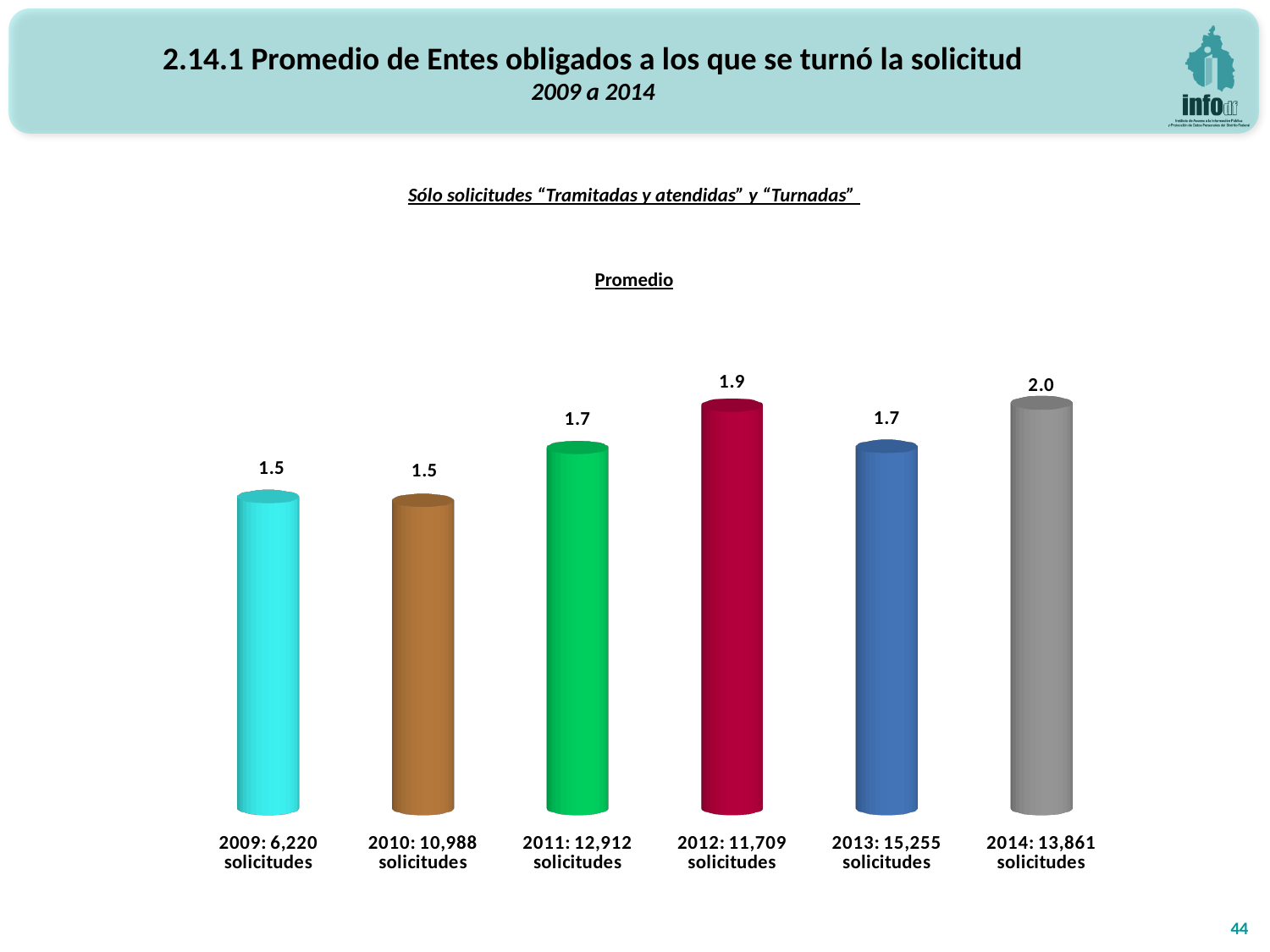
How many solicitudes are indicated in the category label for 2013? 15,255 What is the average value shown for 2014? 2.0 What is the average (Promedio) value shown for 2012? 1.9 Which year has the highest average value? 2014 Which is larger, the average value for 2012 or for 2013? 2012 What is the difference between the average values for 2014 and 2009? 0.5 What is the difference between the average values for 2012 and 2013? 0.2 How many years (bars) are shown in the chart? 6 What is the average value shown for 2009? 1.5 What is the title of the chart on the slide? 2.14.1 Promedio de Entes obligados a los que se turnó la solicitud 2009 a 2014 Do the average values for 2009 and 2010 differ? No, both are 1.5 What type of chart is shown on the slide? Bar chart